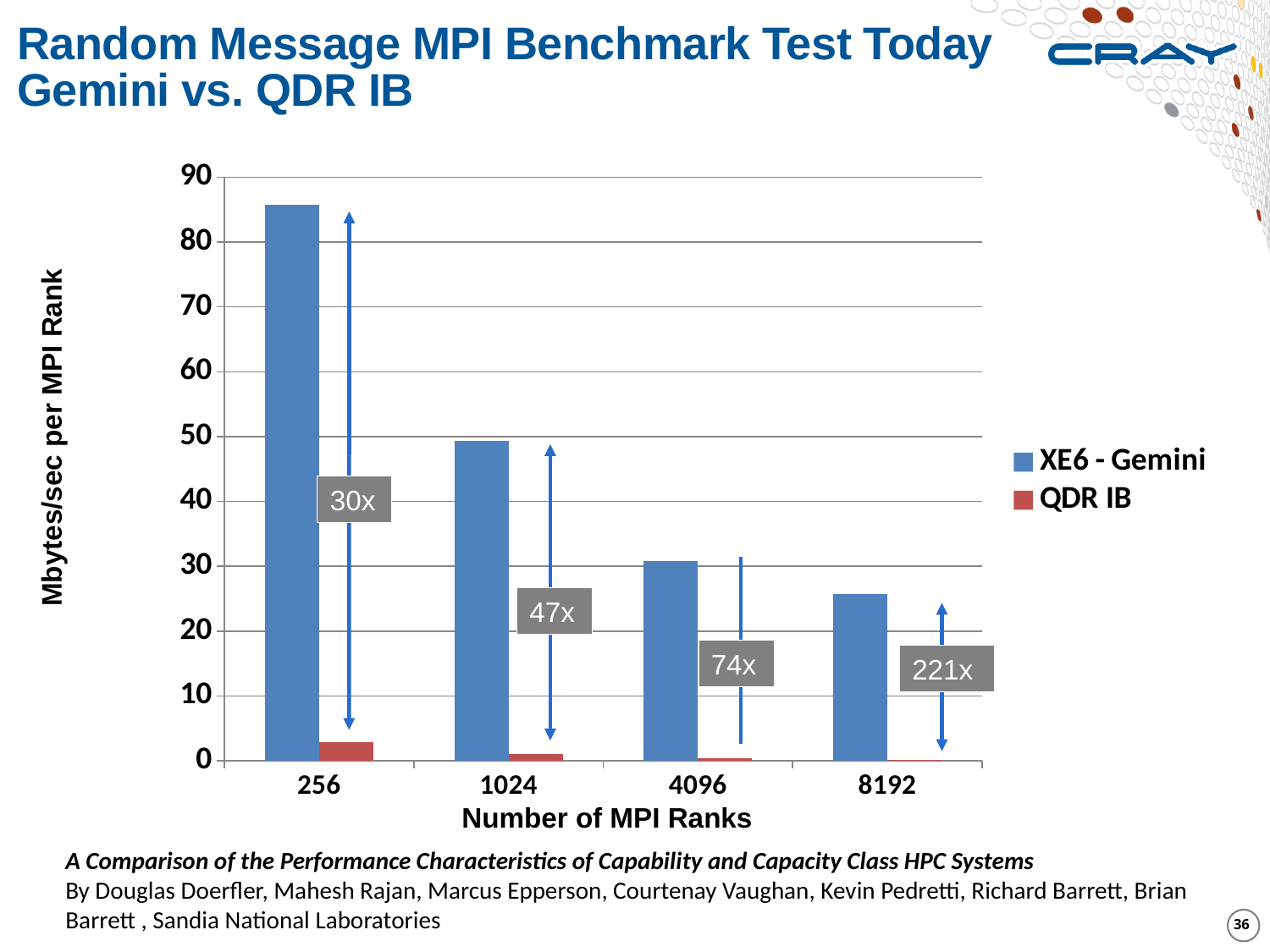
Is the XE6 - Gemini value at 8192 MPI ranks greater or less than 30? less Which is larger, the XE6 - Gemini value at 1024 MPI ranks or at 4096 MPI ranks? 1024 At which number of MPI ranks is the XE6 - Gemini value highest? 256 What speedup factor is annotated for 8192 MPI ranks? 221x Is the XE6 - Gemini value at 256 MPI ranks greater or less than 80? greater How many categories of MPI ranks are shown on the x axis? 4 Is the QDR IB value at 256 MPI ranks greater or less than 10? less Do the XE6 - Gemini values rise or fall as the number of MPI ranks increases? fall What is the title of the y axis? Mbytes/sec per MPI Rank At which number of MPI ranks is the XE6 - Gemini value lowest? 8192 What kind of chart is shown on the slide? bar chart How many series does the legend list? 2